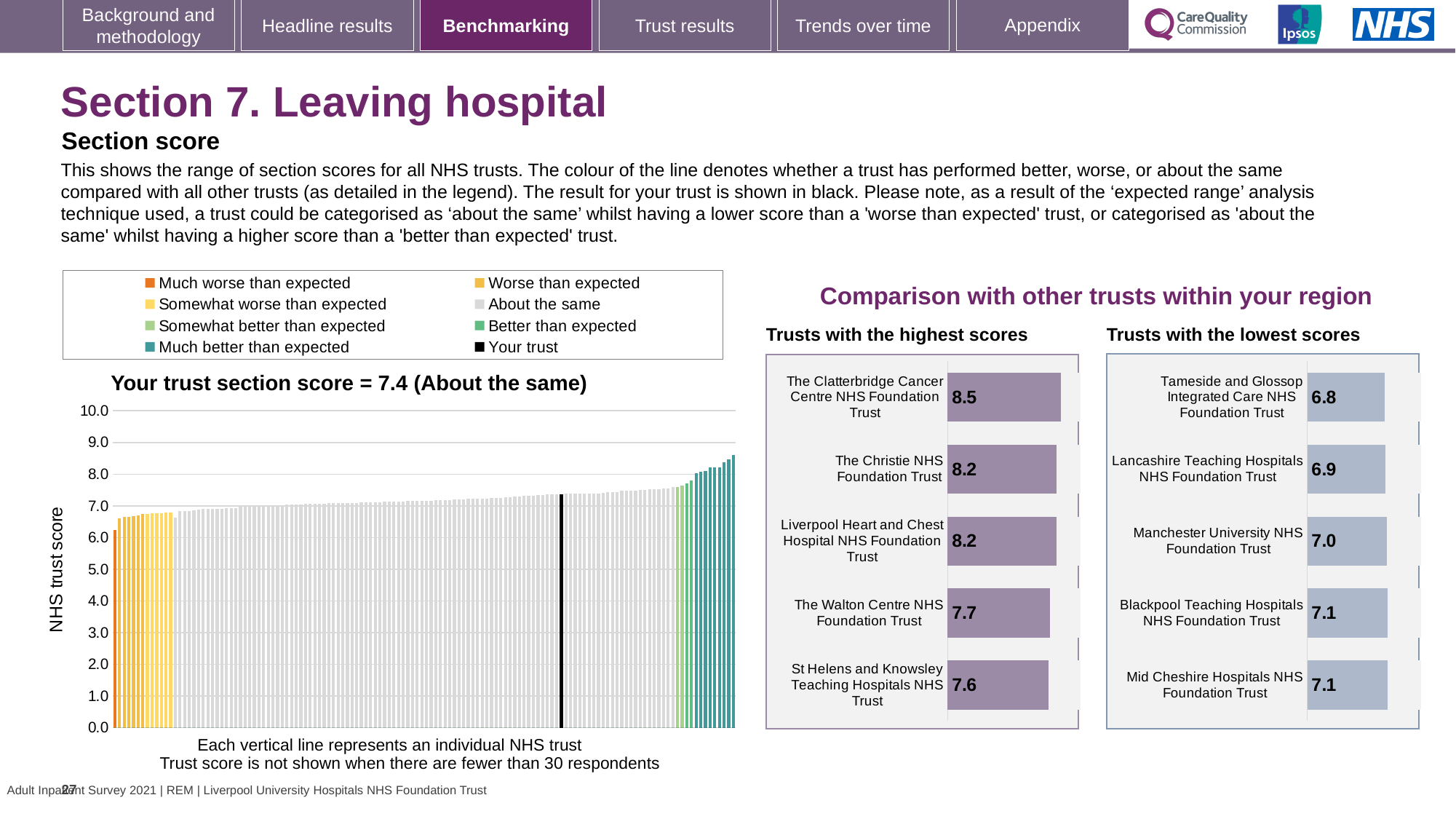
On the 'Trusts with the highest scores' chart, which trust has the lowest score? St Helens and Knowsley Teaching Hospitals NHS Trust On the 'Your trust section score' chart, do the trust scores rise or fall from left to right along the x axis? rise On the 'Trusts with the lowest scores' chart, which trust has the lowest score? Tameside and Glossop Integrated Care NHS Foundation Trust On the 'Your trust section score' chart, how many entries does the legend list? 8 On the 'Trusts with the highest scores' chart, how many trusts are shown? 5 What kind of chart is the 'Your trust section score' chart? bar chart On the 'Trusts with the lowest scores' chart, what is the score for Manchester University NHS Foundation Trust? 7.0 On the 'Trusts with the highest scores' chart, what is the score for The Clatterbridge Cancer Centre NHS Foundation Trust? 8.5 On the 'Your trust section score' chart, is the value of the tallest bar greater or less than 8.0? greater On the 'Trusts with the highest scores' chart, what is the difference between the scores of The Clatterbridge Cancer Centre NHS Foundation Trust and St Helens and Knowsley Teaching Hospitals NHS Trust? 0.9 On the 'Your trust section score' chart, what is the section score for your trust? 7.4 On the 'Trusts with the lowest scores' chart, which has the larger score: Lancashire Teaching Hospitals NHS Foundation Trust or Blackpool Teaching Hospitals NHS Foundation Trust? Blackpool Teaching Hospitals NHS Foundation Trust